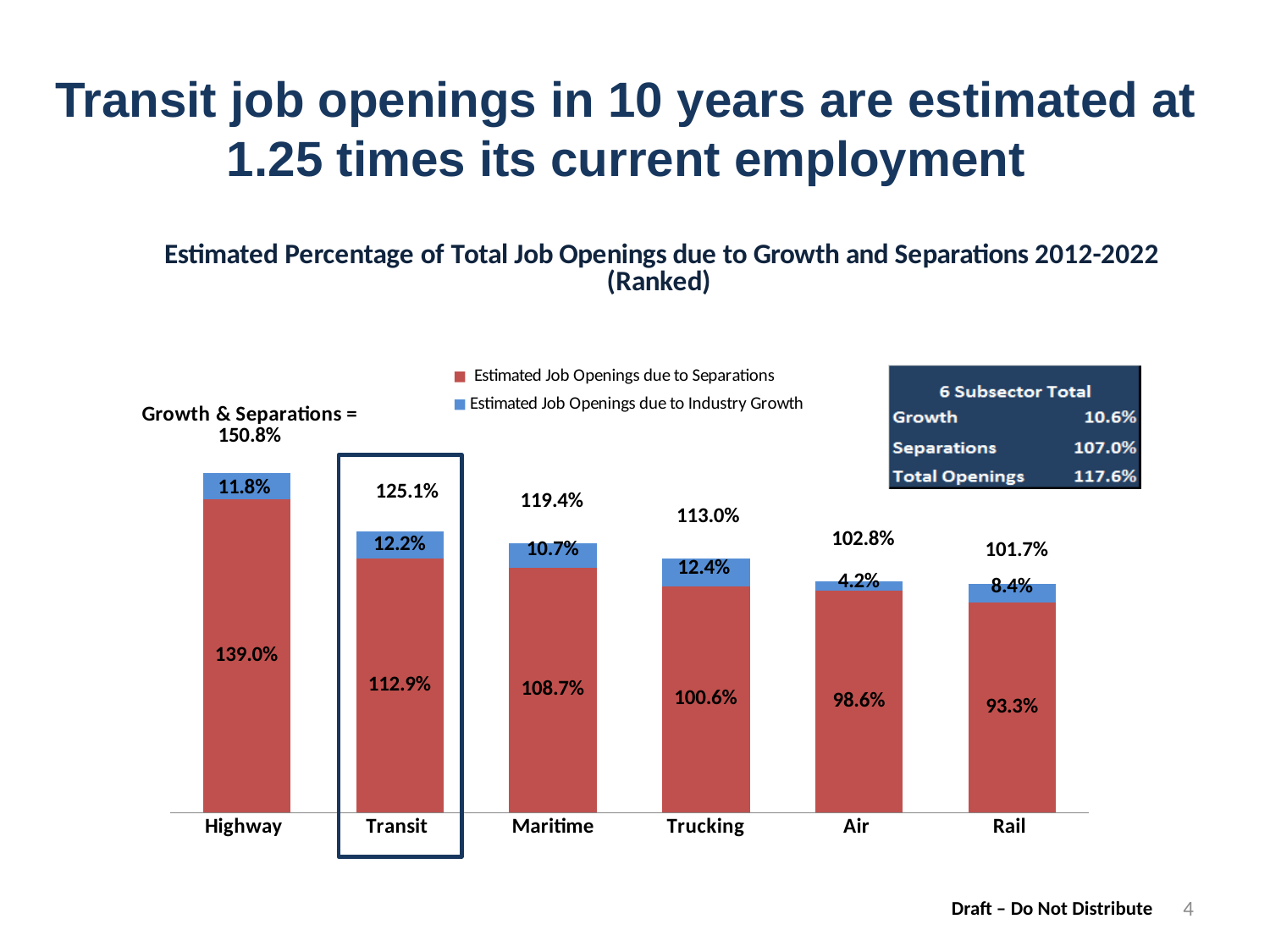
What is the estimated job openings due to separations for Highway? 139.0% What kind of chart is shown on the slide? Stacked bar chart What is the estimated job openings due to industry growth for Transit? 12.2% Which subsector has the highest estimated job openings due to separations? Highway How many series does the legend list? 2 Which subsector has the lowest estimated job openings due to industry growth? Air What is the estimated job openings due to industry growth for Air? 4.2% Which has a larger industry growth value, Trucking or Maritime? Trucking What is the difference between the separations values for Highway and Transit? 26.1% What is the total of the stacked bar for Maritime? 119.4% How many subsectors are shown on the x axis? 6 What is the estimated job openings due to separations for Rail? 93.3%